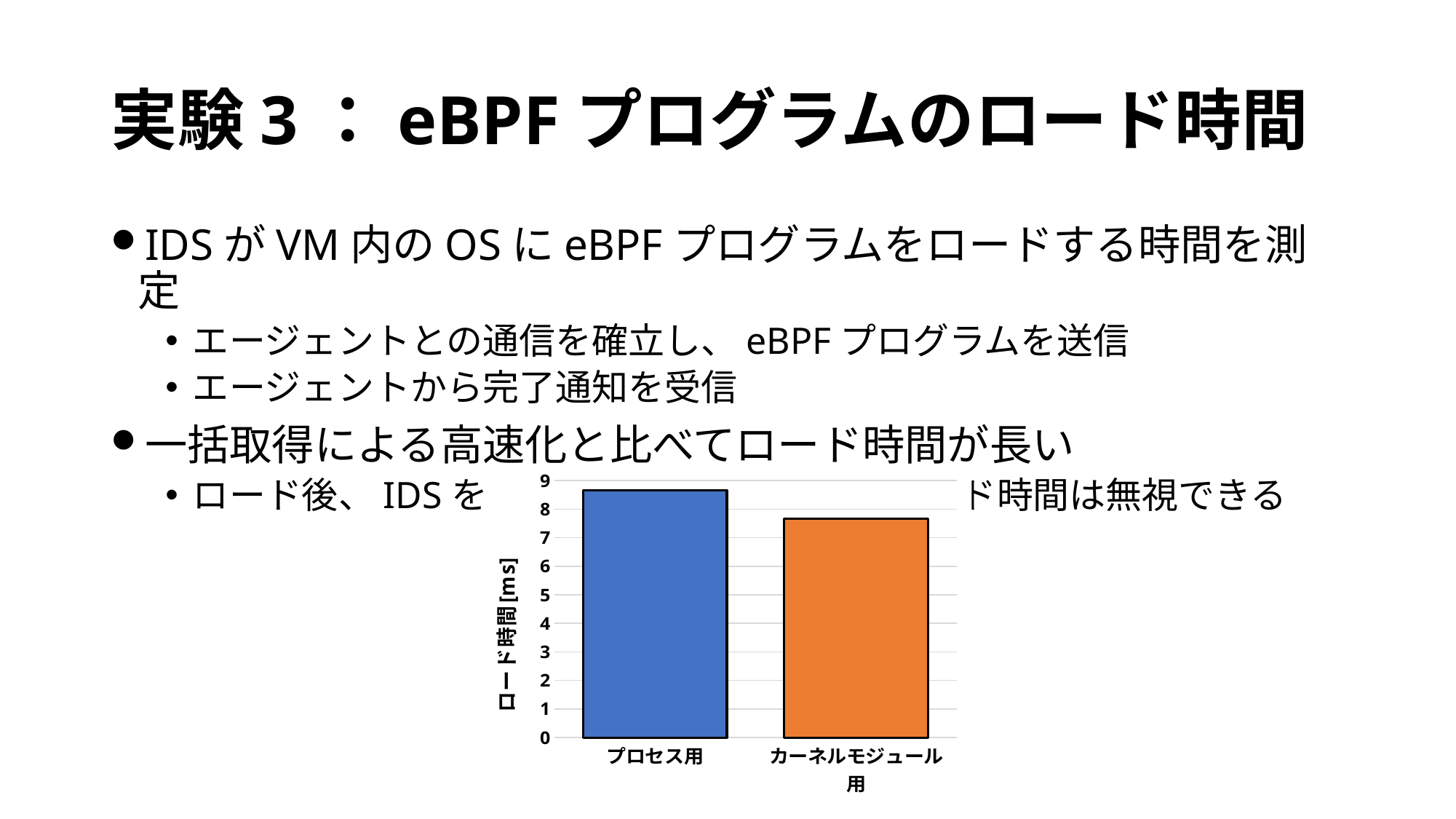
How many bars (categories) does the chart show? 2 Is the value for カーネルモジュール用 greater or less than 7? greater Which category has the lowest load time? カーネルモジュール用 Which is larger, the load time for プロセス用 or for カーネルモジュール用? プロセス用 Is the value for プロセス用 greater or less than 9? less What is the label of the vertical axis of the chart? ロード時間 [ms] What colour is the bar for カーネルモジュール用? orange What kind of chart is shown on the slide? bar chart Is the value for プロセス用 greater or less than 8? greater Which category has the highest load time? プロセス用